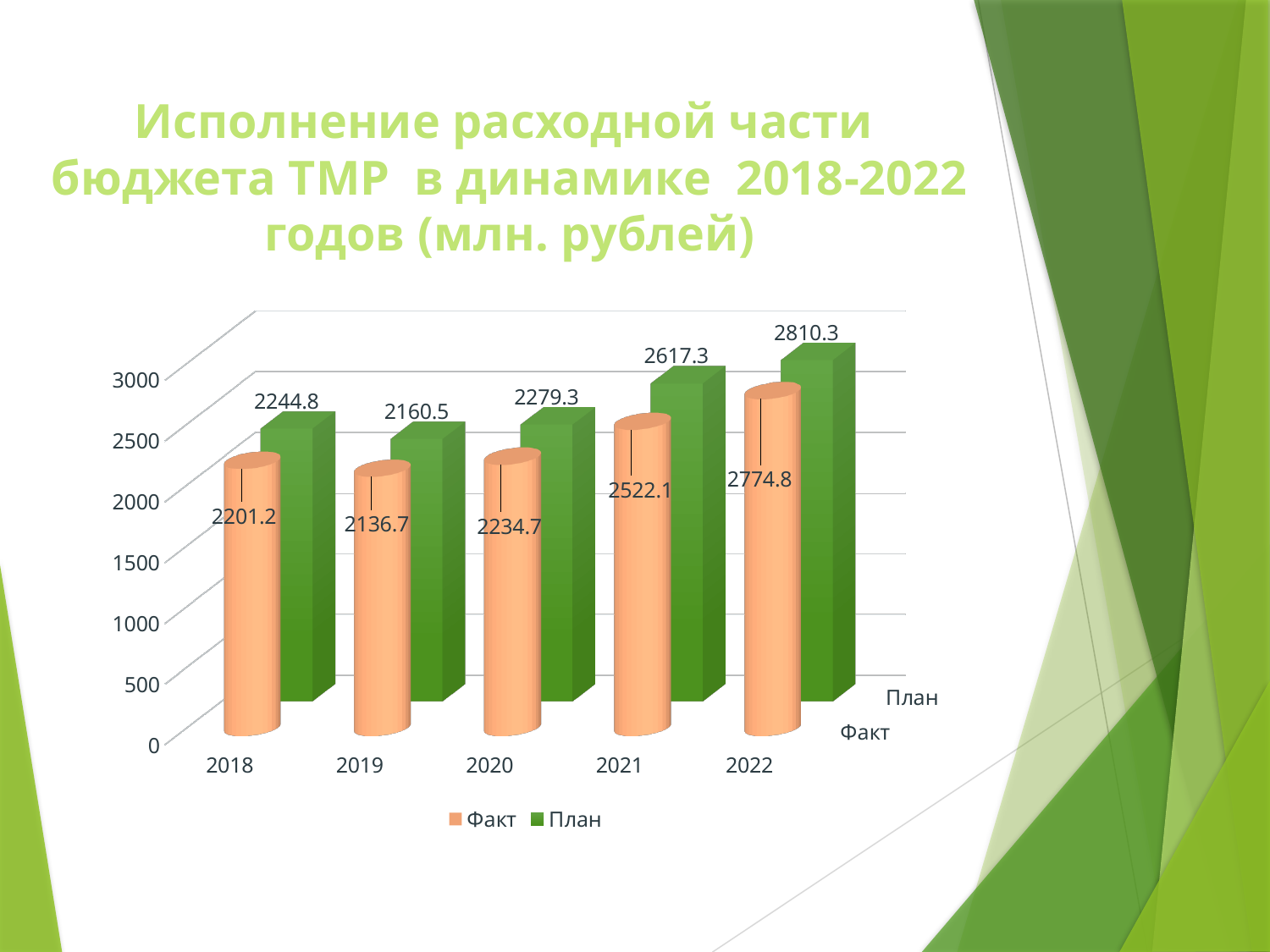
What is the Факт value for 2021? 2522.1 What is the Факт value for 2018? 2201.2 Which is larger for 2020, the Факт value or the План value? План Which year has the highest Факт value? 2022 How many years are shown on the x axis? 5 By how much did the Факт value increase from 2018 to 2022? 573.6 What is the difference between the План and Факт values for 2022? 35.5 Which year has the lowest План value? 2019 What kind of chart is shown on the slide? Bar chart How many series does the legend list? 2 What is the План value for 2019? 2160.5 What is the План value for 2022? 2810.3